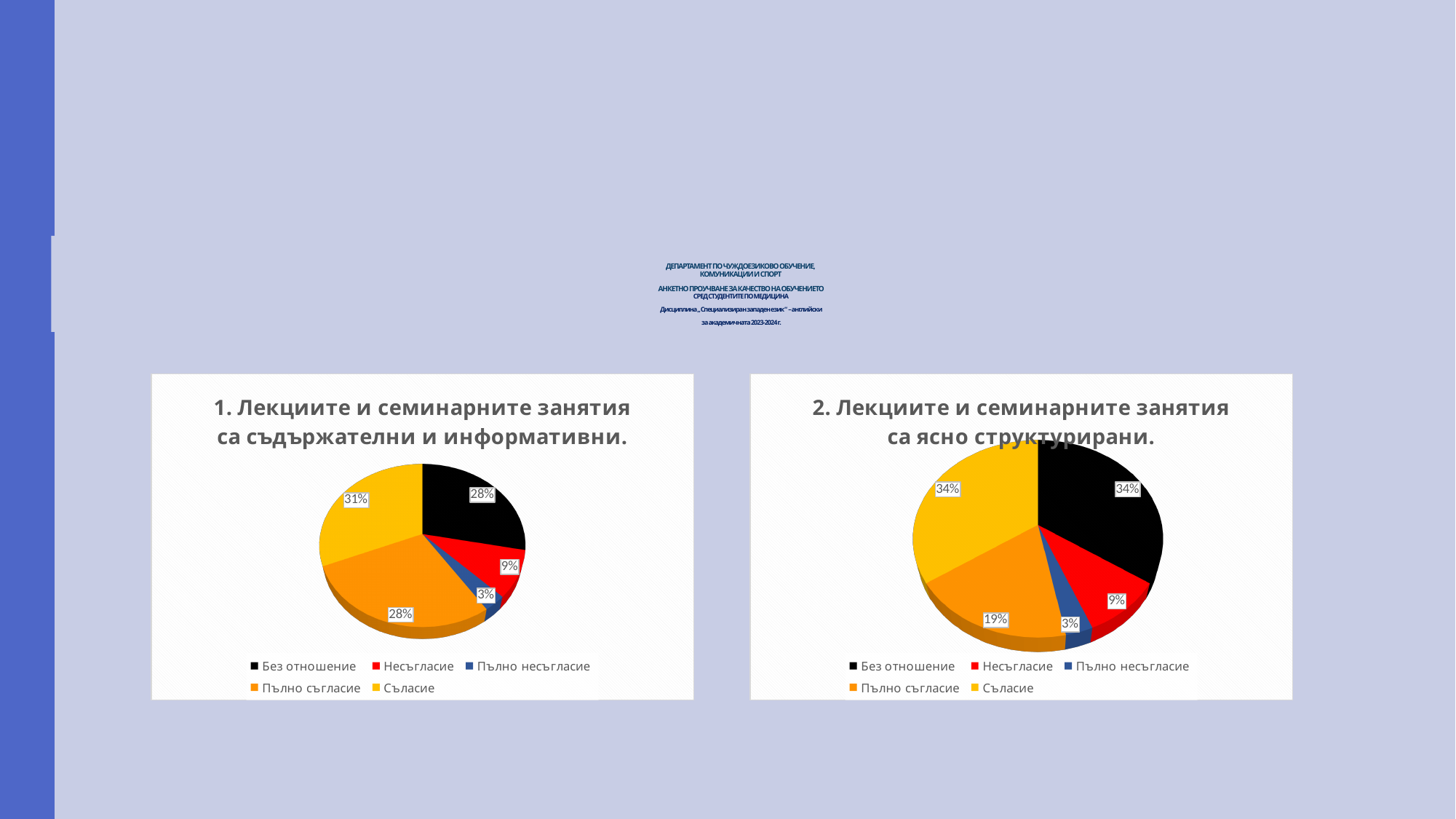
In the left chart ("1. Лекциите и семинарните занятия са съдържателни и информативни."), what is the difference between the Съгласие and Пълно съгласие shares? 3% In the right chart ("2. Лекциите и семинарните занятия са ясно структурирани."), which category has the smallest slice? Пълно несъгласие In the left chart ("1. Лекциите и семинарните занятия са съдържателни и информативни."), what share is labelled for Съгласие? 31% In the right chart ("2. Лекциите и семинарните занятия са ясно структурирани."), which is larger: Пълно съгласие or Несъгласие? Пълно съгласие How many categories does the legend of the left chart list? 5 In the left chart ("1. Лекциите и семинарните занятия са съдържателни и информативни."), which category has the largest slice? Съгласие In the right chart ("2. Лекциите и семинарните занятия са ясно структурирани."), what is the difference between the Съгласие and Пълно съгласие shares? 15% In the left chart ("1. Лекциите и семинарните занятия са съдържателни и информативни."), which category has the smallest slice? Пълно несъгласие What kind of chart is the right chart ("2. Лекциите и семинарните занятия са ясно структурирани.")? Pie chart In the right chart ("2. Лекциите и семинарните занятия са ясно структурирани."), what share is labelled for Пълно съгласие? 19% In the right chart ("2. Лекциите и семинарните занятия са ясно структурирани."), what share is labelled for Без отношение? 34% In the left chart ("1. Лекциите и семинарните занятия са съдържателни и информативни."), what share is labelled for Несъгласие? 9%